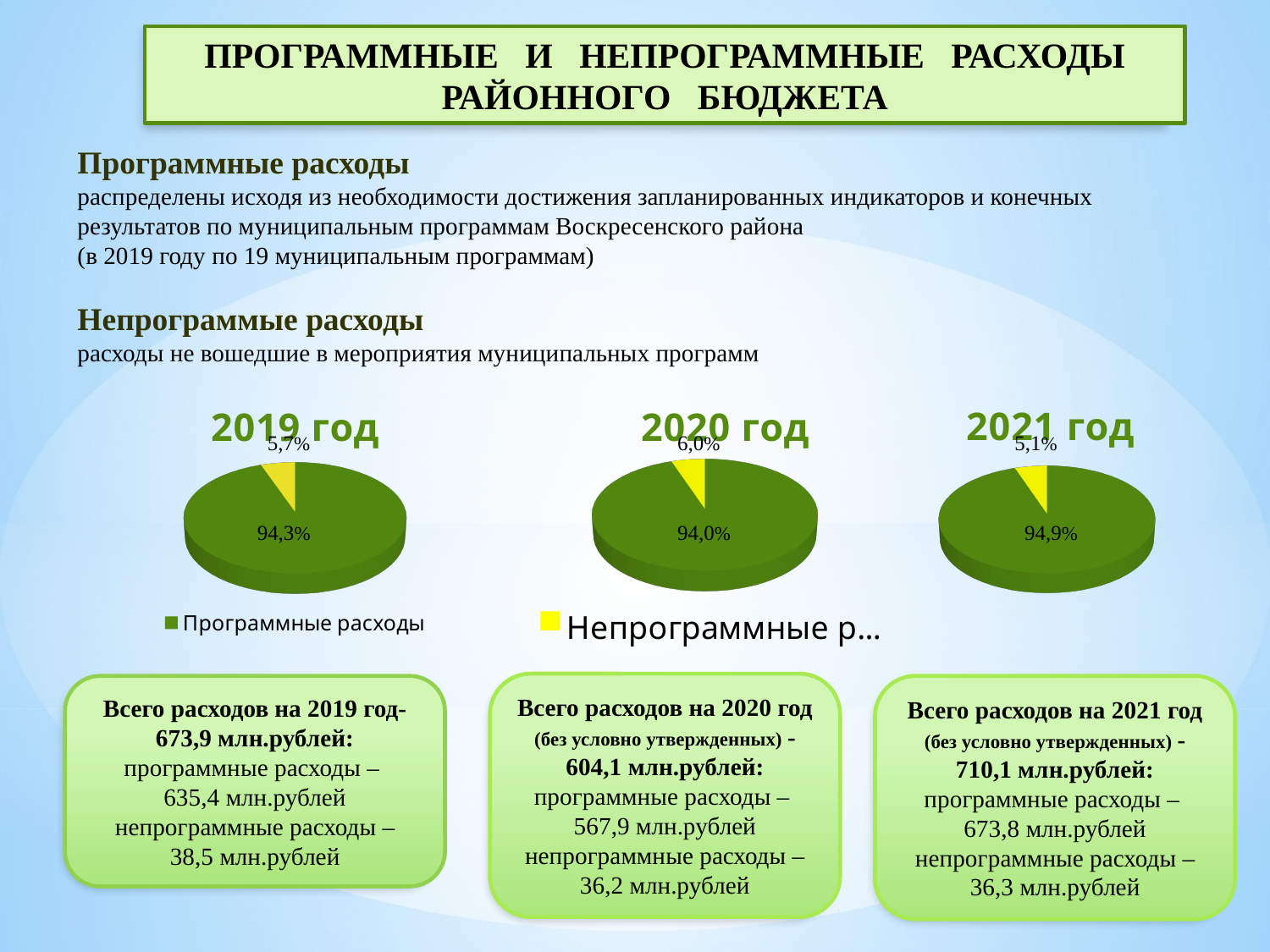
What colour represents Программные расходы in the pie charts? Green In the 2019 год pie chart, what share is shown for Непрограммные расходы? 5,7% In the 2019 год pie chart, what share is shown for Программные расходы? 94,3% In the 2020 год pie chart, what share is shown for Непрограммные расходы? 6,0% In the 2021 год pie chart, what share is shown for Программные расходы? 94,9% In the 2019 год pie chart, which slice is the smallest? Непрограммные расходы In the 2020 год pie chart, what share is shown for Программные расходы? 94,0% In the 2021 год pie chart, what share is shown for Непрограммные расходы? 5,1% How many slices does the 2020 год pie chart have? 2 In the 2021 год pie chart, which slice is the largest? Программные расходы Which year's pie chart shows the larger share for Непрограммные расходы: 2020 год or 2021 год? 2020 год What kind of chart is used for the 2019 год, 2020 год and 2021 год data? Pie chart